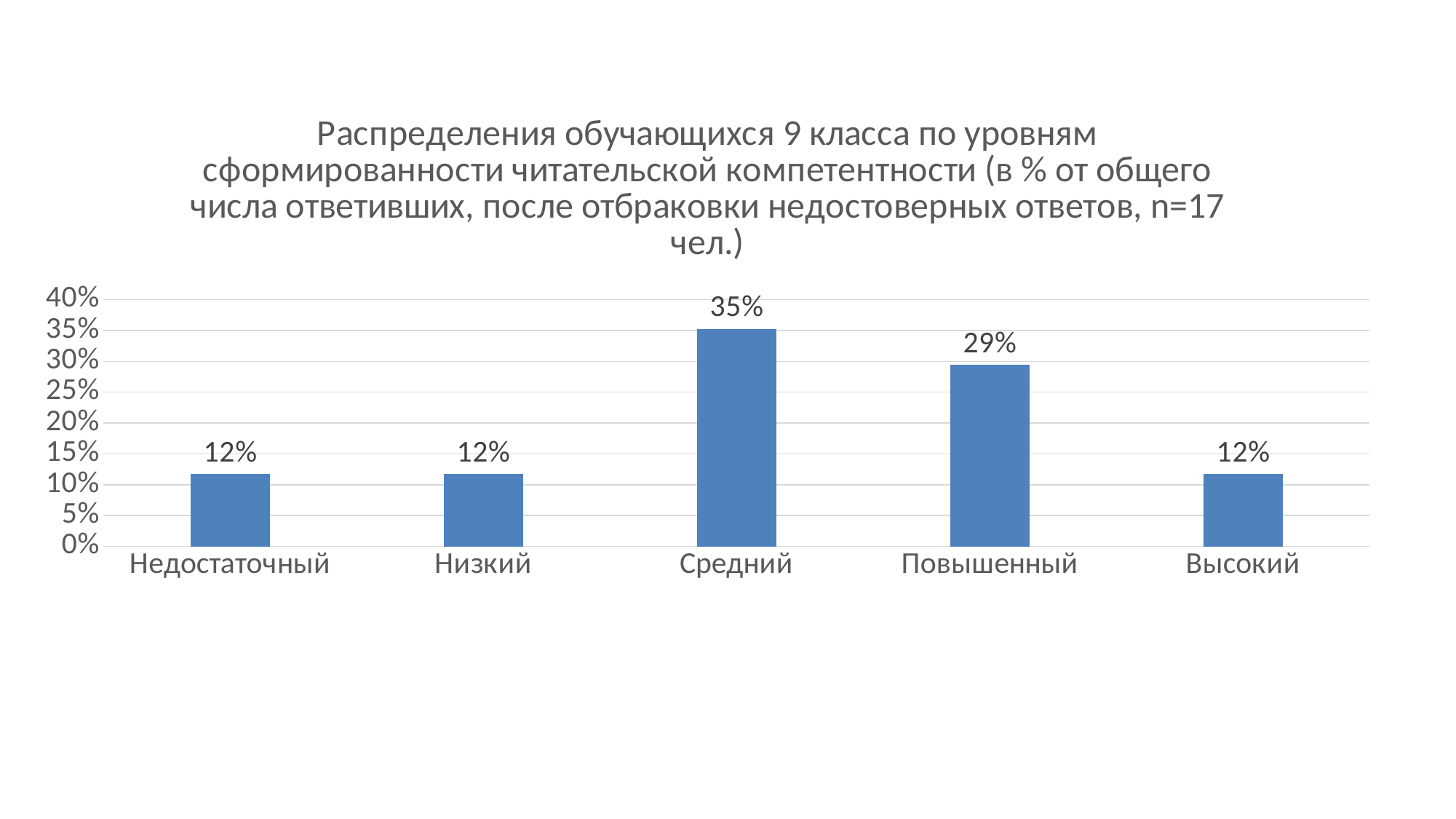
What is the difference between the values for Средний and Повышенный? 6% Is the value for Повышенный greater or less than 20%? greater What is the value for Высокий? 12% What is the difference between the values for Повышенный and Недостаточный? 17% Which is larger, the value for Средний or the value for Повышенный? Средний Which category has the highest value? Средний What is the value for Низкий? 12% What is the value for Повышенный? 29% How many categories are shown on the x axis? 5 What is the value for Средний? 35% What kind of chart is shown on the slide? bar chart What is the sample size (n) stated in the chart title? 17